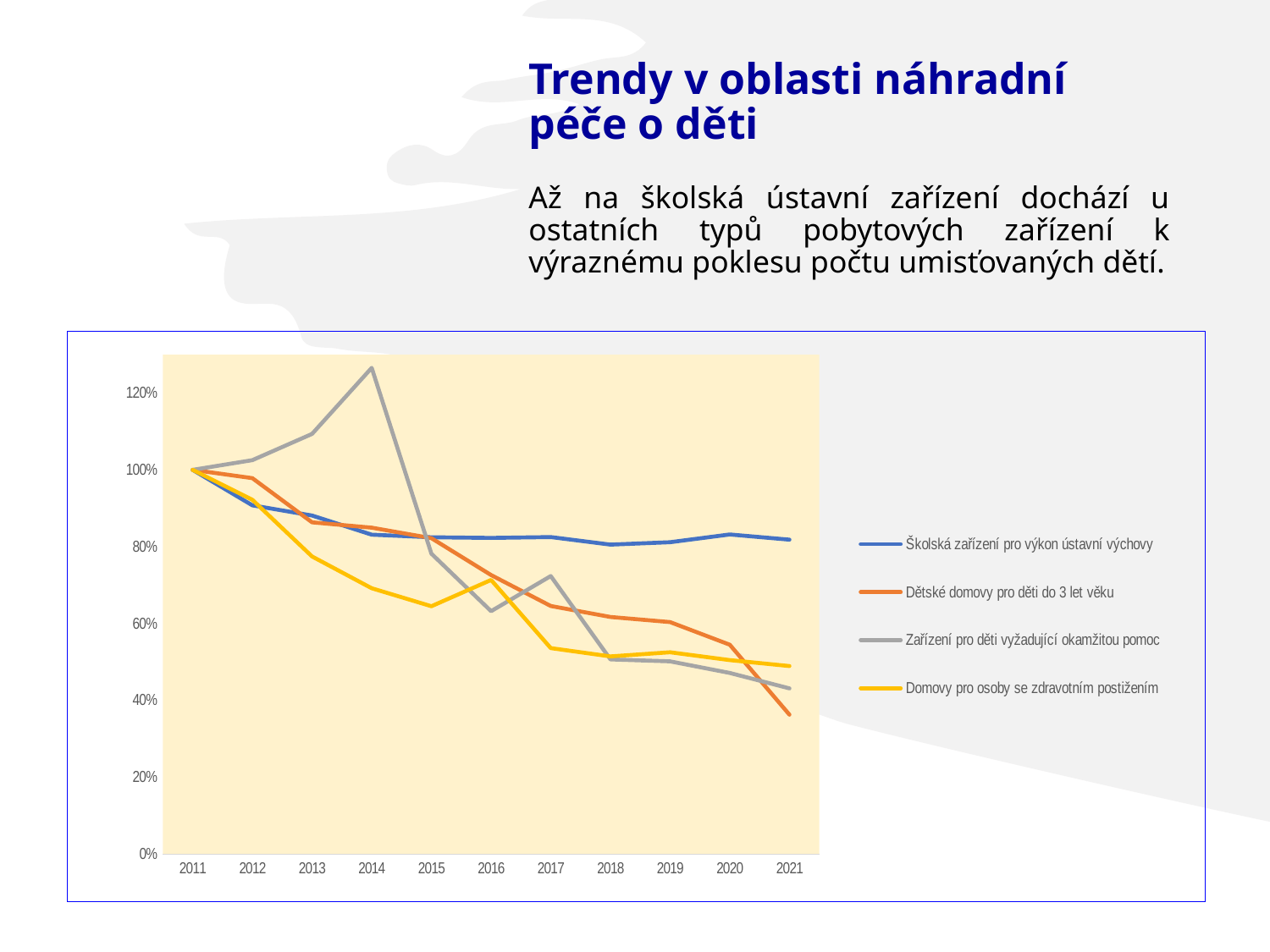
In 2021, which is larger: Školská zařízení pro výkon ústavní výchovy or Domovy pro osoby se zdravotním postižením? Školská zařízení pro výkon ústavní výchovy How many series does the legend list? 4 Which series has the highest value in 2014? Zařízení pro děti vyžadující okamžitou pomoc Which series has the lowest value in 2021? Dětské domovy pro děti do 3 let věku Is the value for Školská zařízení pro výkon ústavní výchovy in 2021 greater or less than 80%? greater Is the value for Zařízení pro děti vyžadující okamžitou pomoc in 2014 greater or less than 120%? greater What is the value for Dětské domovy pro děti do 3 let věku in 2011? 100% Do the values for Dětské domovy pro děti do 3 let věku rise or fall from 2011 to 2021? fall How many years are shown on the x axis? 11 Is the value for Dětské domovy pro děti do 3 let věku in 2021 greater or less than 40%? less What kind of chart is shown on the slide? line chart What colour is the line for Školská zařízení pro výkon ústavní výchovy? blue